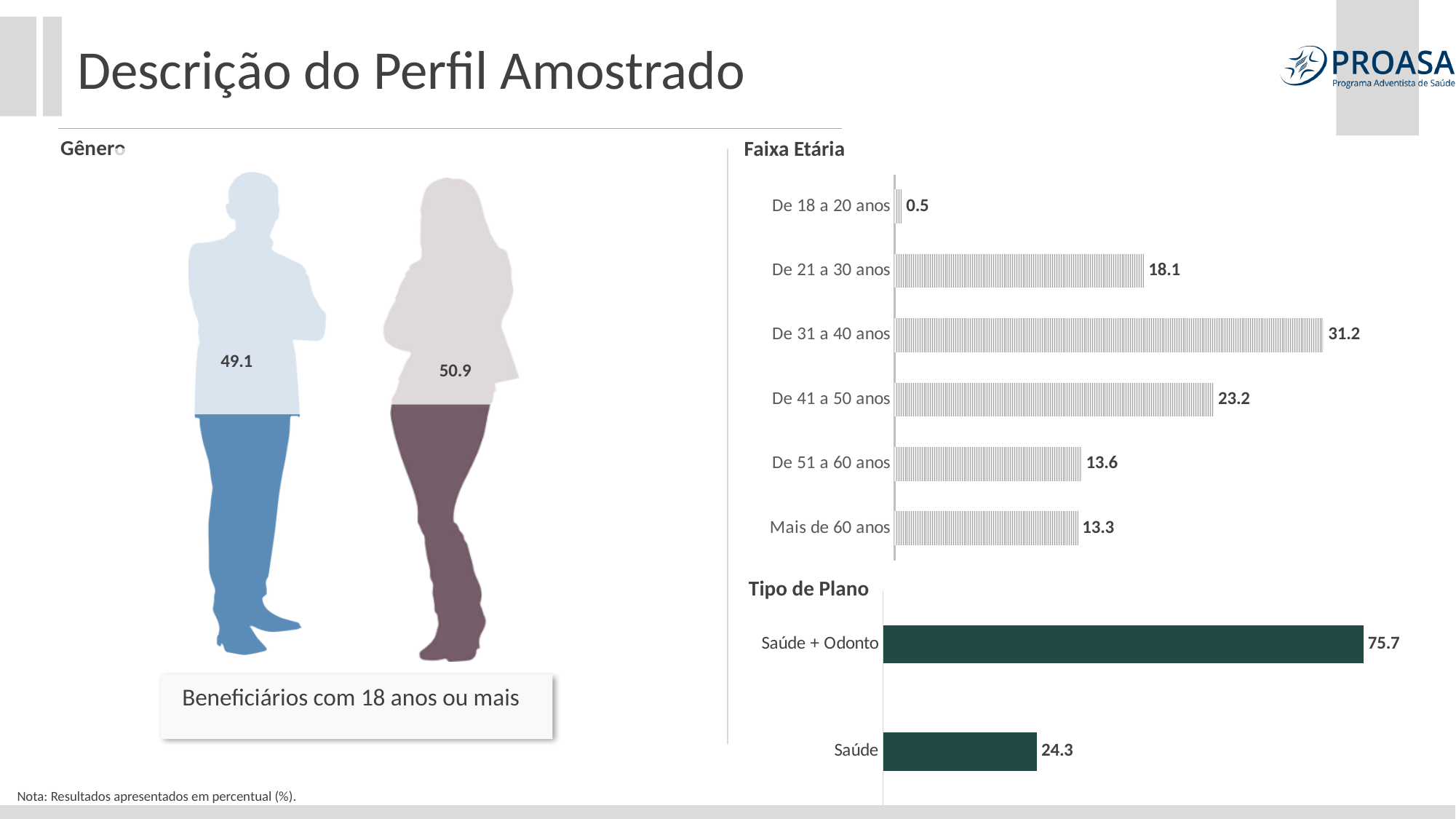
What kind of chart is the Faixa Etária chart? Bar chart In the Tipo de Plano chart, what is the difference between Saúde + Odonto and Saúde? 51.4 How many age groups are shown in the Faixa Etária chart? 6 In the Faixa Etária chart, what is the value for De 31 a 40 anos? 31.2 In the Gênero chart, what is the value shown for the female figure? 50.9 In the Faixa Etária chart, which is larger: De 51 a 60 anos or Mais de 60 anos? De 51 a 60 anos In the Gênero chart, which is larger: the male value or the female value? Female (50.9) In the Faixa Etária chart, which age group has the lowest value? De 18 a 20 anos In the Faixa Etária chart, what is the difference between De 41 a 50 anos and De 21 a 30 anos? 5.1 In the Faixa Etária chart, what is the value for De 18 a 20 anos? 0.5 In the Tipo de Plano chart, what is the value for Saúde + Odonto? 75.7 In the Faixa Etária chart, which age group has the highest value? De 31 a 40 anos